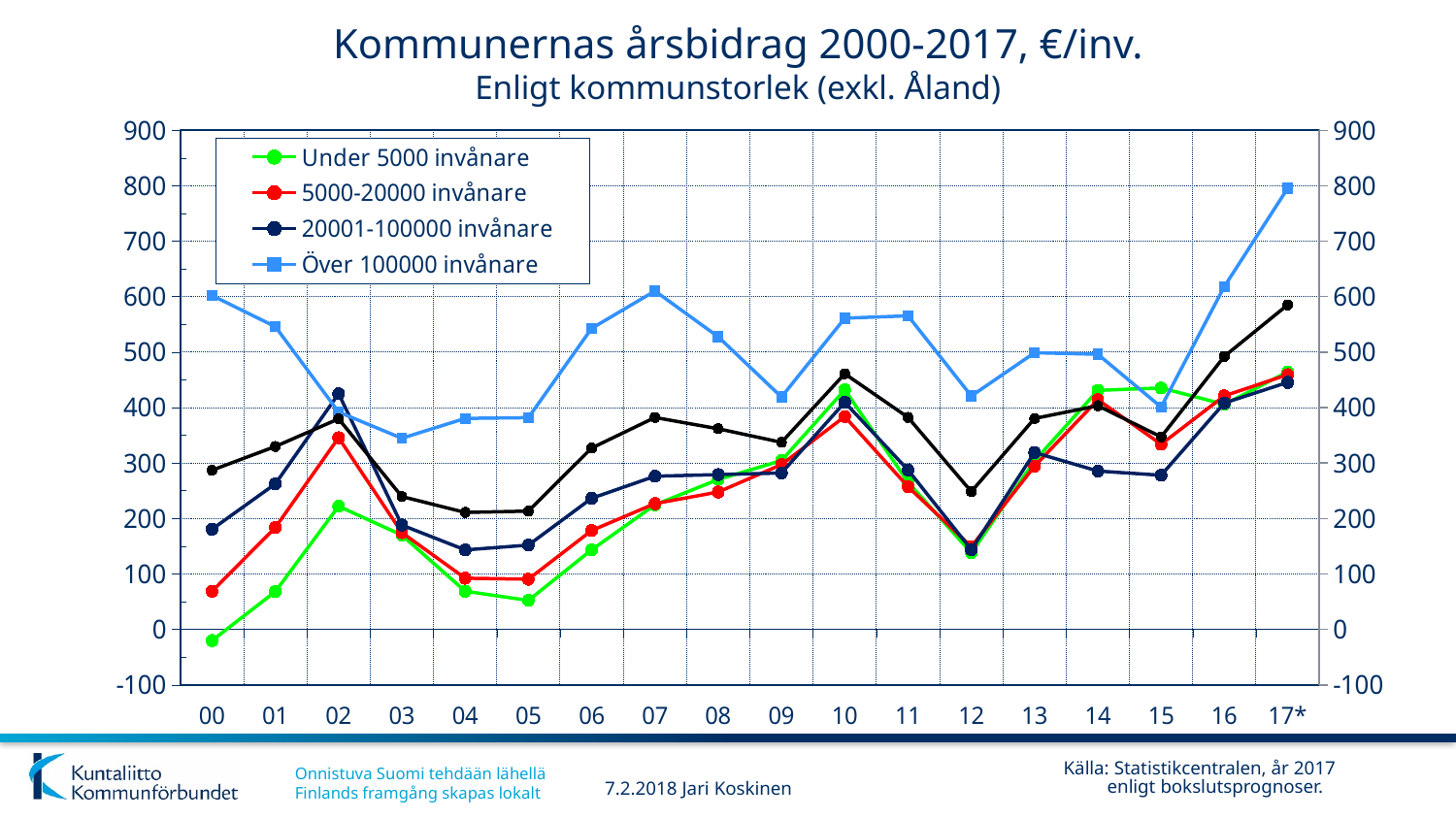
What is the main title of the chart? Kommunernas årsbidrag 2000-2017, €/inv. In 02, which is larger: Över 100000 invånare or Under 5000 invånare? Över 100000 invånare In which year does the Under 5000 invånare series have its lowest value? 00 Is the value for Över 100000 invånare in 17* greater or less than 700? greater Is the value for 5000-20000 invånare in 02 greater or less than 300? greater How many series does the legend list? 4 Does the Över 100000 invånare series rise or fall from 15 to 17*? rise Is the value for Under 5000 invånare in 00 greater or less than 0? less What kind of chart is shown on the slide? line chart How many years are shown along the x axis? 18 In which year does the Över 100000 invånare series reach its highest value? 17*